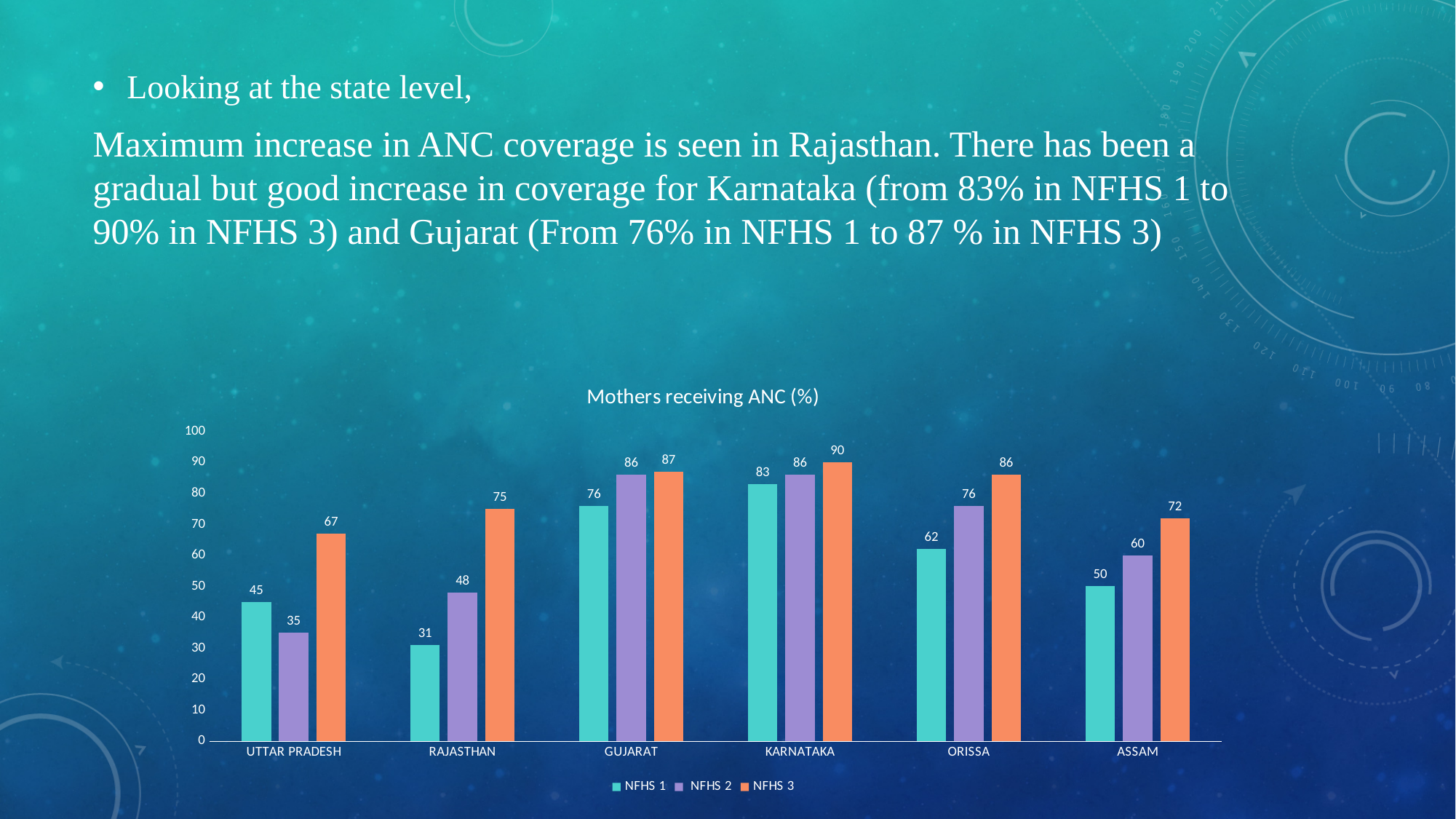
What is the NFHS 2 value for Orissa? 76 Which is larger for Assam: the NFHS 1 value or the NFHS 2 value? NFHS 2 What is the NFHS 1 value for Uttar Pradesh? 45 How many series does the legend list? 3 What kind of chart is shown on the slide? Bar chart What is the difference between the NFHS 3 and NFHS 1 values for Rajasthan? 44 What is the title of the chart? Mothers receiving ANC (%) Which state has the lowest NFHS 1 value? Rajasthan How many states are shown on the x axis? 6 What is the difference between the NFHS 2 values for Gujarat and Uttar Pradesh? 51 Which state has the highest NFHS 3 value? Karnataka What is the NFHS 3 value for Rajasthan? 75